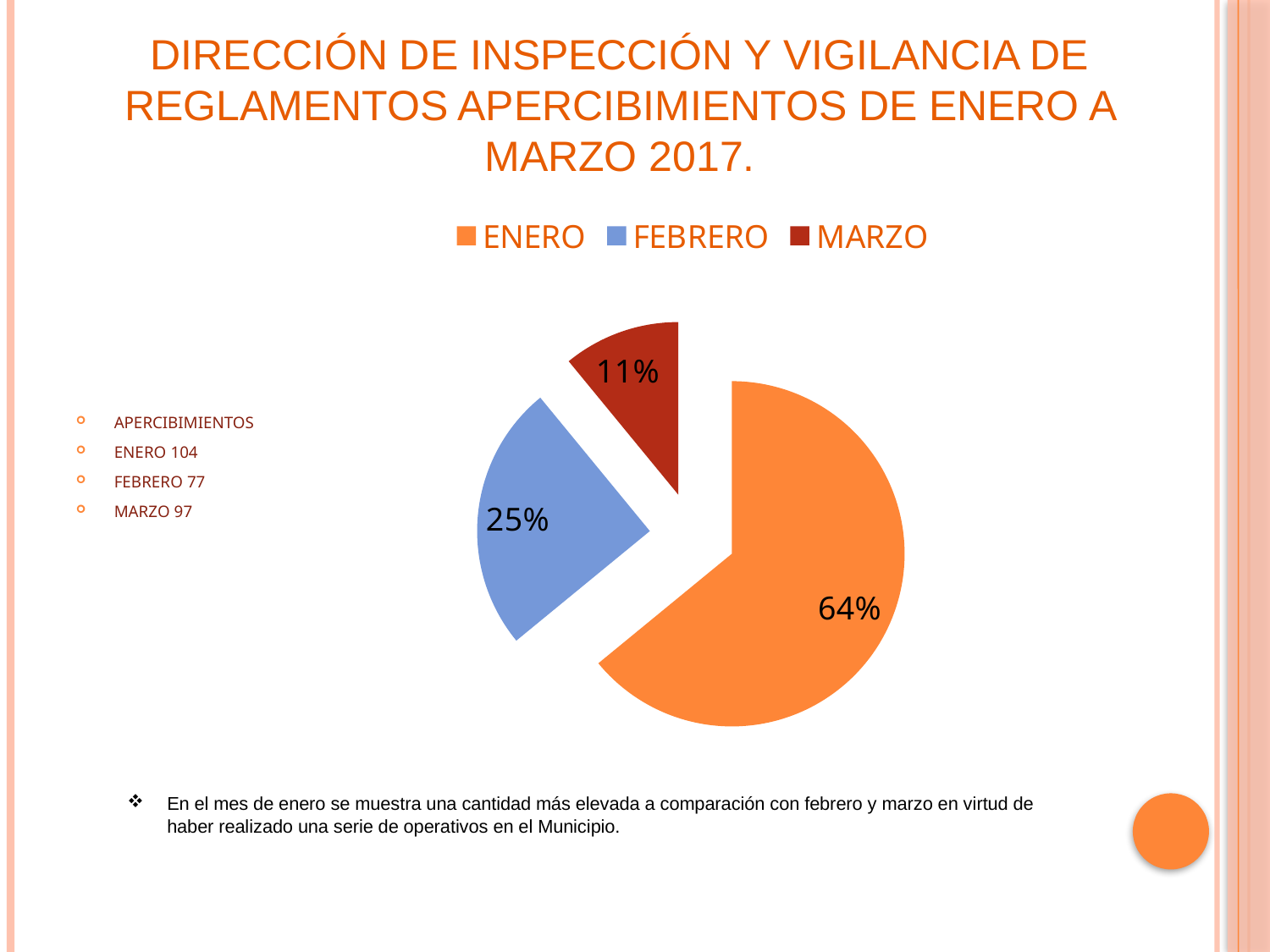
What colour is the MARZO slice in the pie chart? dark red Which month has the largest slice of the pie? ENERO What is the difference in percentage points between the ENERO slice and the FEBRERO slice? 39 What percentage of the pie does the MARZO slice represent? 11% What percentage of the pie does the ENERO slice represent? 64% Which month has the smallest slice of the pie? MARZO How many slices does the pie chart have? 3 What kind of chart is shown on the slide? pie chart How many entries does the legend list? 3 What is the difference in percentage points between the FEBRERO slice and the MARZO slice? 14 What percentage of the pie does the FEBRERO slice represent? 25% Which slice is larger, FEBRERO or MARZO? FEBRERO